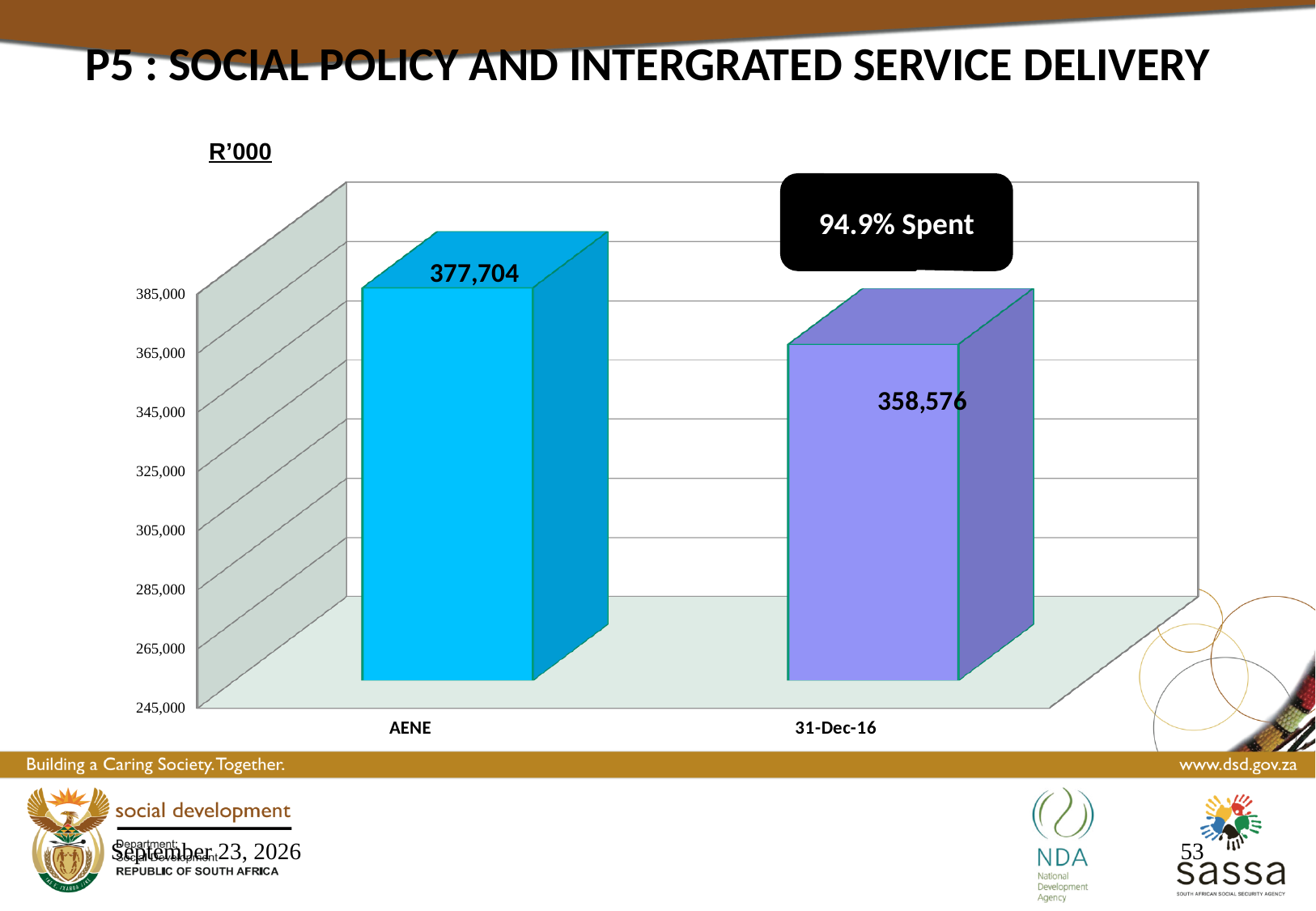
What is the value for 31-Dec-16? 358,576 What is the difference between the AENE value and the 31-Dec-16 value? 19,128 Is the value for AENE greater or less than 365,000? greater Which category has the highest value? AENE Is the value for 31-Dec-16 greater or less than 365,000? less How many bars are shown in the chart? 2 Which is larger, the value for AENE or the value for 31-Dec-16? AENE What is the value for AENE? 377,704 What percentage spent is shown in the callout on the chart? 94.9% Spent Which category has the lowest value? 31-Dec-16 What kind of chart is shown on the slide? bar chart What unit label is shown above the chart? R'000